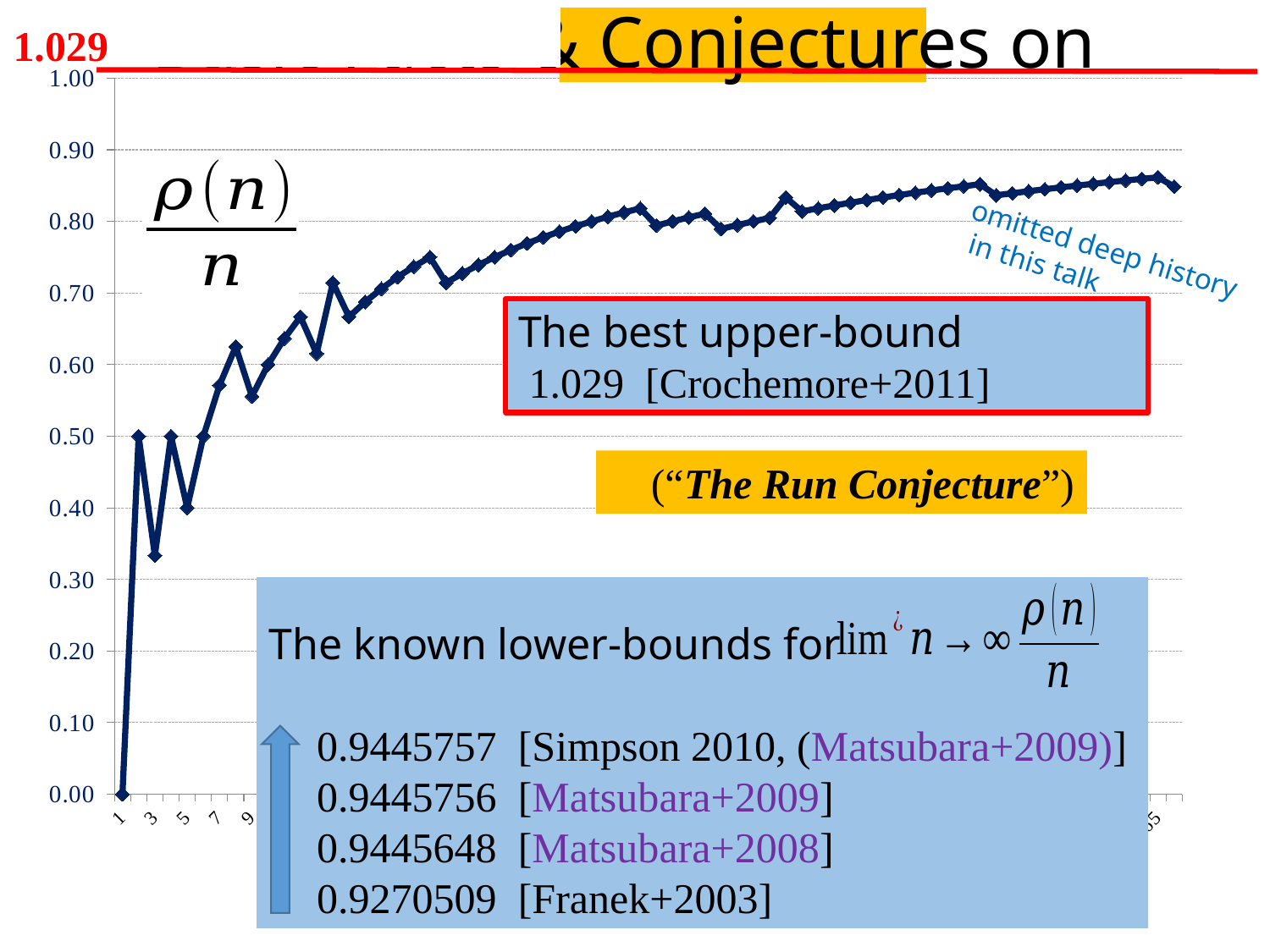
What is the plotted value of ρ(n)/n at n = 5? 0.40 What value is marked by the red horizontal line at the top of the chart? 1.029 Is the plotted value of ρ(n)/n at the right end of the chart greater or less than 0.80? greater Is the plotted value of ρ(n)/n at n = 3 greater or less than 0.40? less Overall, do the plotted values of ρ(n)/n rise or fall as n increases along the x axis? rise Which is larger, the plotted ρ(n)/n at n = 2 or at n = 3? n = 2 What kind of chart is shown on the slide? line chart What is the plotted value of ρ(n)/n at n = 2? 0.50 What is the plotted value of ρ(n)/n at n = 1? 0.00 At which value of n is the plotted ρ(n)/n lowest? 1 Is the highest plotted value of ρ(n)/n greater or less than 0.90? less What quantity is plotted on the y axis of the chart? ρ(n)/n